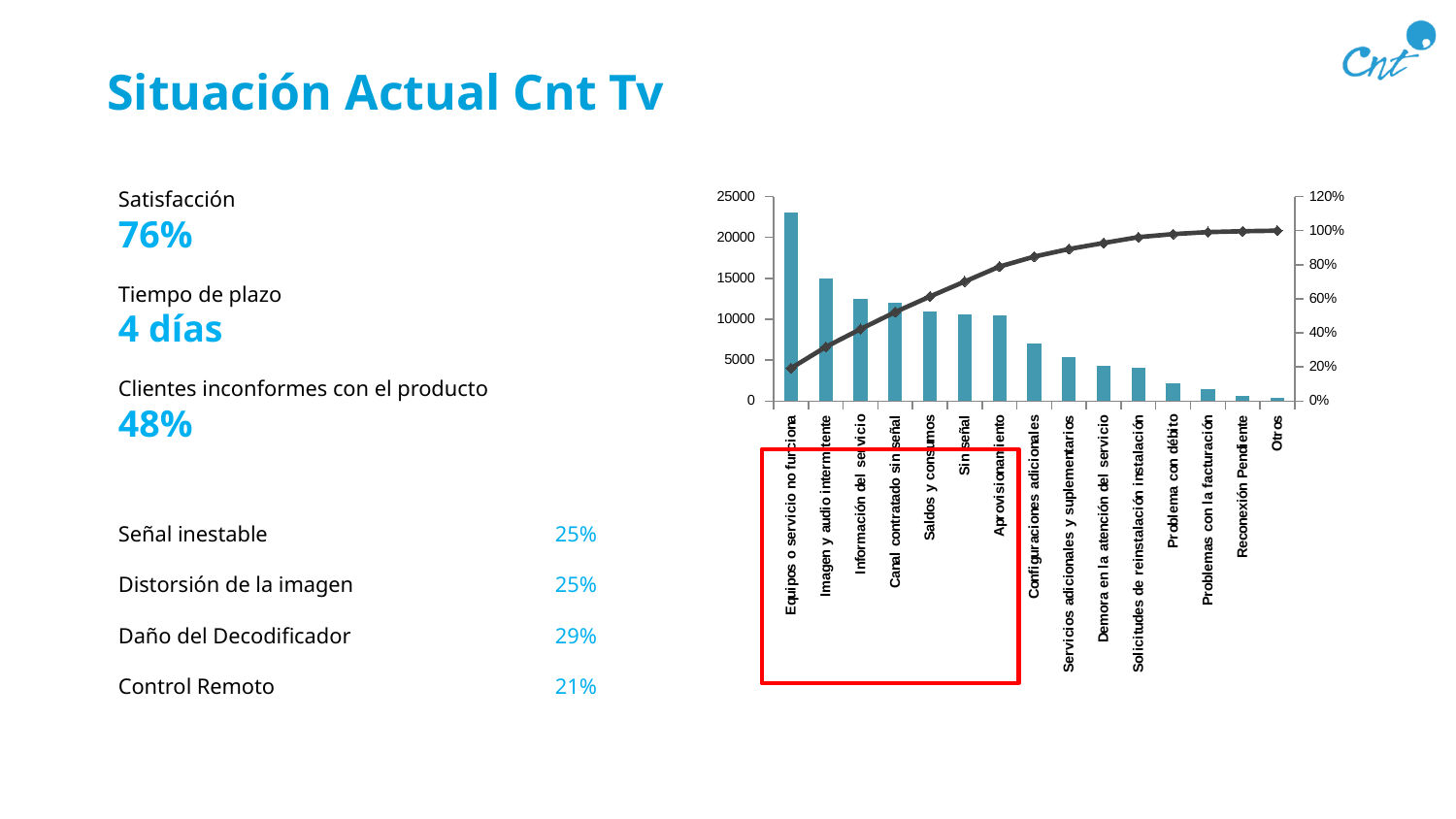
Which category has the tallest bar in the chart? Equipos o servicio no funciona What kind of chart is shown on the slide? Bar chart with a cumulative line (Pareto chart) Do the bar values rise or fall from left to right along the x axis? fall Is the bar value for Información del servicio greater or less than 10000? greater Which bar is taller: Configuraciones adicionales or Demora en la atención del servicio? Configuraciones adicionales Is the bar value for Configuraciones adicionales greater or less than 5000? greater Which bar is taller: Imagen y audio intermitente or Información del servicio? Imagen y audio intermitente Which category has the shortest bar in the chart? Otros How many categories are plotted along the x axis of the chart? 15 Is the bar value for Equipos o servicio no funciona greater or less than 20000? greater What is the highest tick shown on the right-hand percentage axis of the chart? 120%